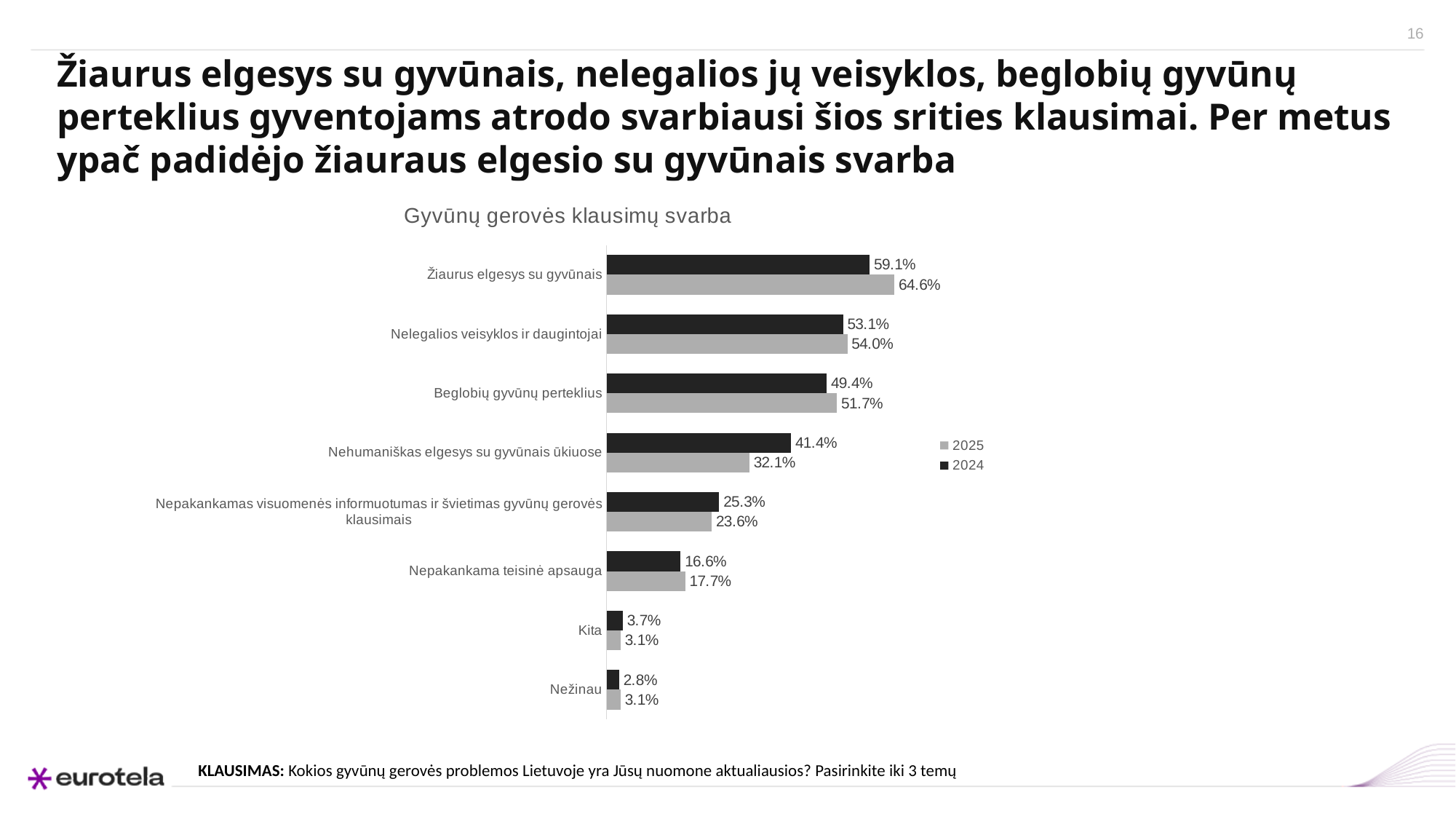
What is the 2025 value for Nepakankama teisinė apsauga? 17.7% What is the title of the chart? Gyvūnų gerovės klausimų svarba How many categories are shown in the chart? 8 What is the 2025 value for Žiaurus elgesys su gyvūnais? 64.6% What is the difference between the 2024 and 2025 values for Nehumaniškas elgesys su gyvūnais ūkiuose? 9.3% Which category has the highest 2025 value? Žiaurus elgesys su gyvūnais What kind of chart is shown on the slide? Bar chart What is the 2024 value for Nehumaniškas elgesys su gyvūnais ūkiuose? 41.4% How many series does the legend list? 2 What is the difference between the 2025 and 2024 values for Žiaurus elgesys su gyvūnais? 5.5% For Nelegalios veisyklos ir daugintojai, which year has the larger value, 2024 or 2025? 2025 Which category has the lowest 2024 value? Nežinau